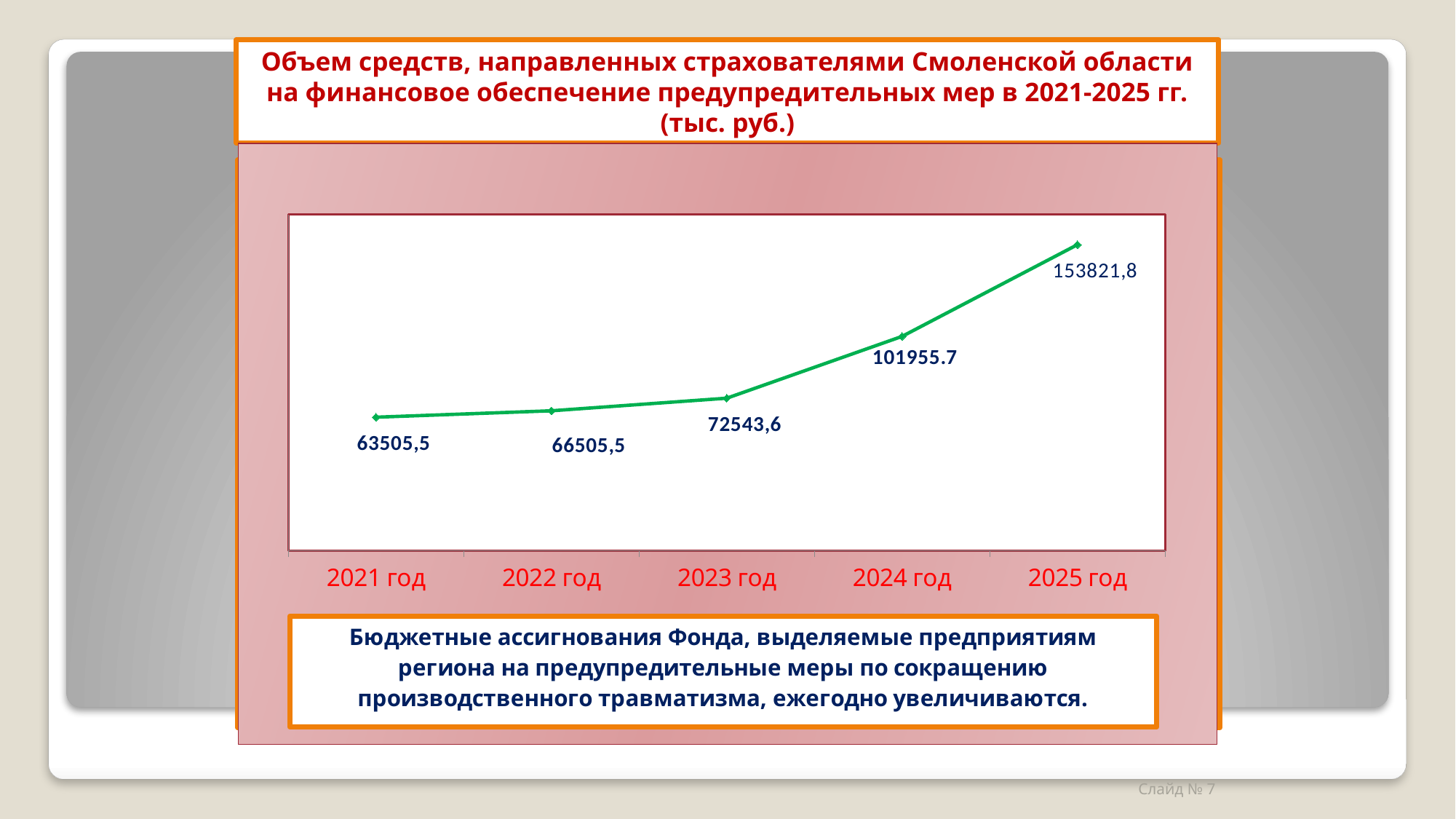
Which year has the highest value? 2025 год What is the value for 2021 год? 63505,5 What is the value for 2025 год? 153821,8 How many years are plotted on the chart? 5 What is the value for 2024 год? 101955.7 What is the value for 2023 год? 72543,6 Do the values rise or fall from 2021 год to 2025 год? Rise Which year has the lowest value? 2021 год What is the difference between the values for 2025 год and 2024 год? 51866,1 What is the difference between the values for 2022 год and 2021 год? 3000,0 What kind of chart is shown on the slide? Line chart Which is larger, the value for 2023 год or the value for 2024 год? 2024 год